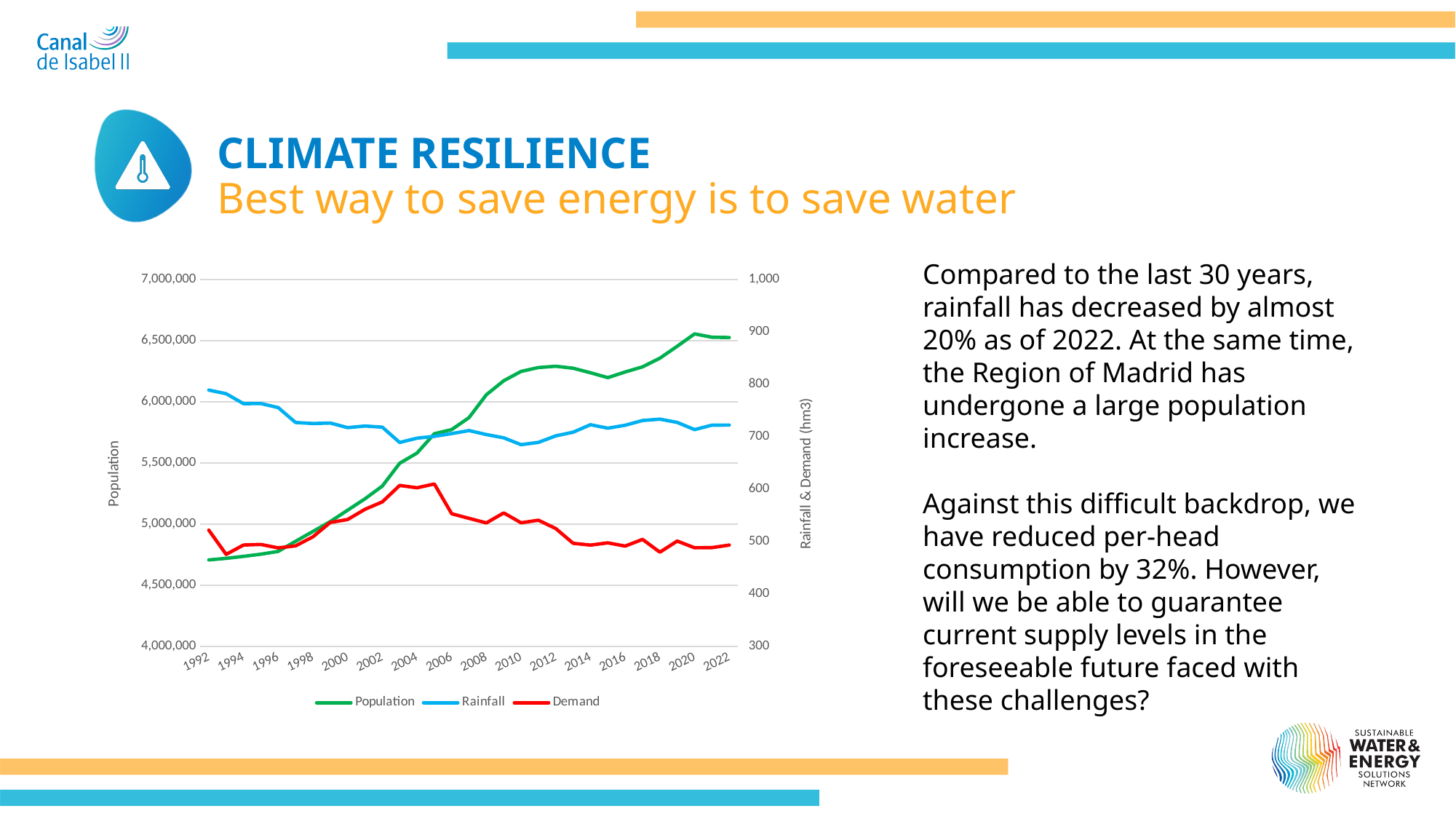
How many series does the chart legend list? 3 Is the Demand value for 2022 greater or less than 600? less Is the Population value for 1992 greater or less than 5,000,000? less Does the Population series rise or fall from 1992 to 2022? Rise Is the Rainfall value for 1992 greater or less than 700? greater Which series are listed in the chart legend? Population, Rainfall, Demand In 2022, which is larger on the right-hand axis: Rainfall or Demand? Rainfall What is the title of the right-hand vertical axis of the chart? Rainfall & Demand (hm3) How many year labels are shown on the x axis of the chart? 16 Does the Demand series rise or fall from 2006 to 2022? Fall What kind of chart is shown on the slide? Line chart